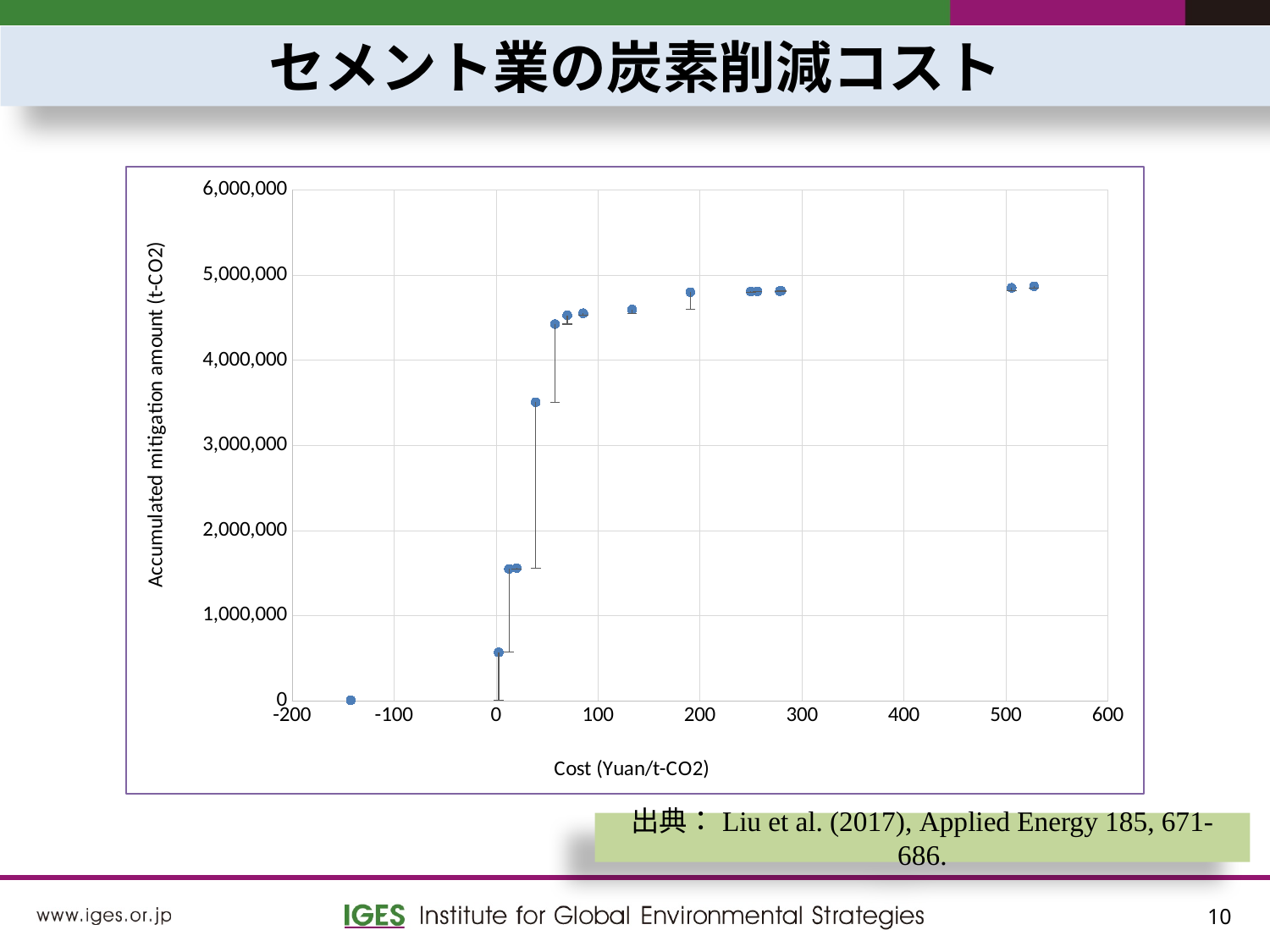
Which has the higher accumulated mitigation amount: the point at a cost of around 40 Yuan/t-CO2 or the point at a cost of around 130 Yuan/t-CO2? The point at around 130 Yuan/t-CO2 Is the accumulated mitigation amount for the points at a cost of around 500 Yuan/t-CO2 greater or less than 4,000,000? greater Is the accumulated mitigation amount for the leftmost point (at a negative cost) greater or less than 1,000,000? less What is the highest value shown on the y axis of the chart? 6,000,000 Does the point with the lowest accumulated mitigation amount have a negative or a positive cost? Negative What kind of chart is shown on the slide? Scatter chart What is the label of the x axis of the chart? Cost (Yuan/t-CO2) Is the accumulated mitigation amount for the points at a cost of around 10-20 Yuan/t-CO2 greater or less than 2,000,000? less What is the label of the y axis of the chart? Accumulated mitigation amount (t-CO2) As cost increases along the x axis, does the accumulated mitigation amount rise or fall? Rise